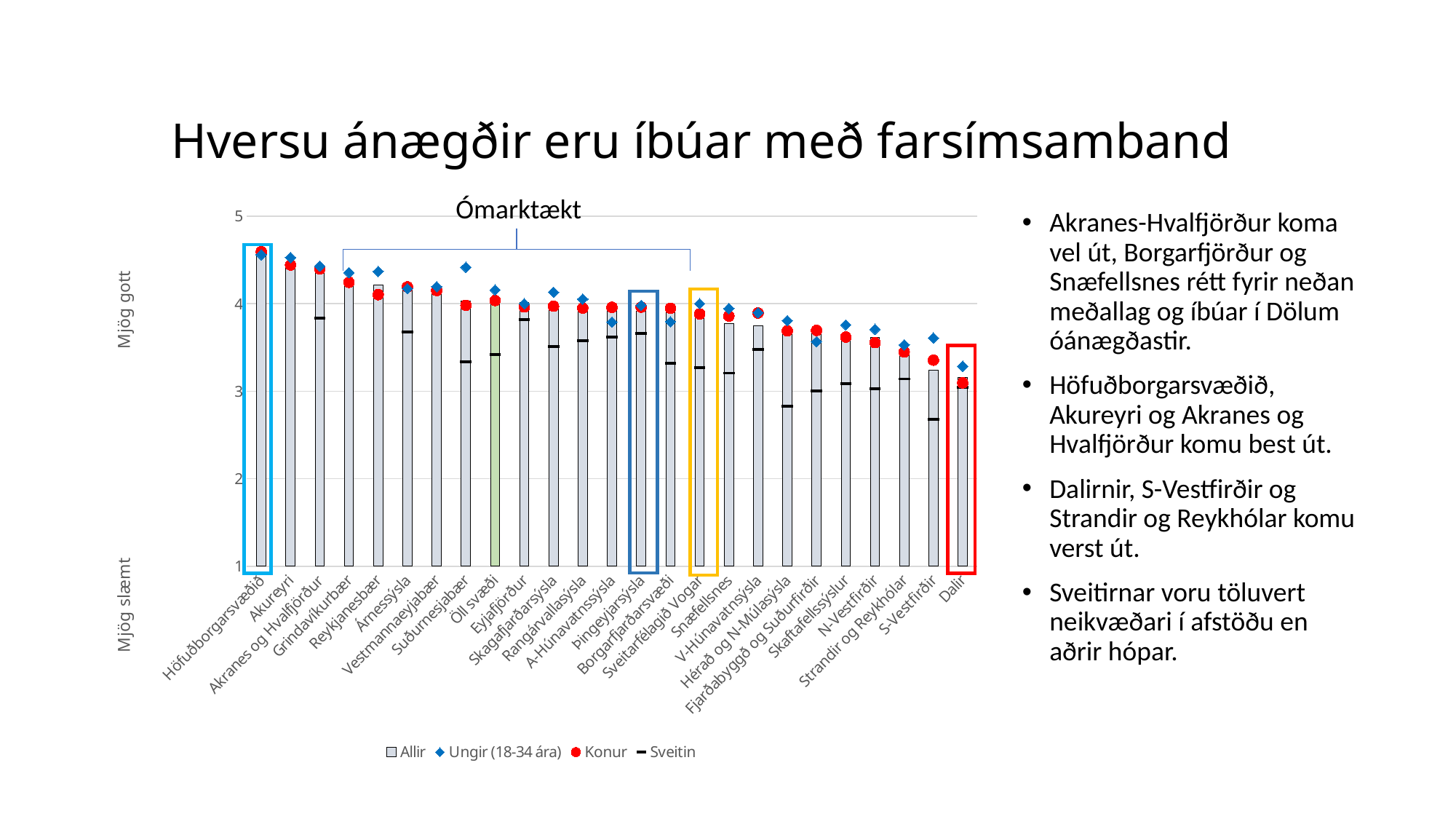
How many regions (categories) are shown along the x axis of the chart? 25 What is the title of the slide containing the chart? Hversu ánægðir eru íbúar með farsímsamband Which series in the legend is shown with blue diamond markers? Ungir (18-34 ára) Is the 'Allir' value for Dalir greater or less than 4? less What kind of chart is shown on the slide? bar chart Do the 'Allir' bar values rise or fall from left to right along the x axis? fall Which has a larger 'Allir' value, Akureyri or Dalir? Akureyri How many series does the chart legend list? 4 Which region has the lowest 'Allir' bar in the chart? Dalir Is the 'Sveitin' value for S-Vestfirðir greater or less than 3? less Which region has the highest 'Allir' bar in the chart? Höfuðborgarsvæðið Is the 'Allir' value for Höfuðborgarsvæðið greater or less than 4? greater